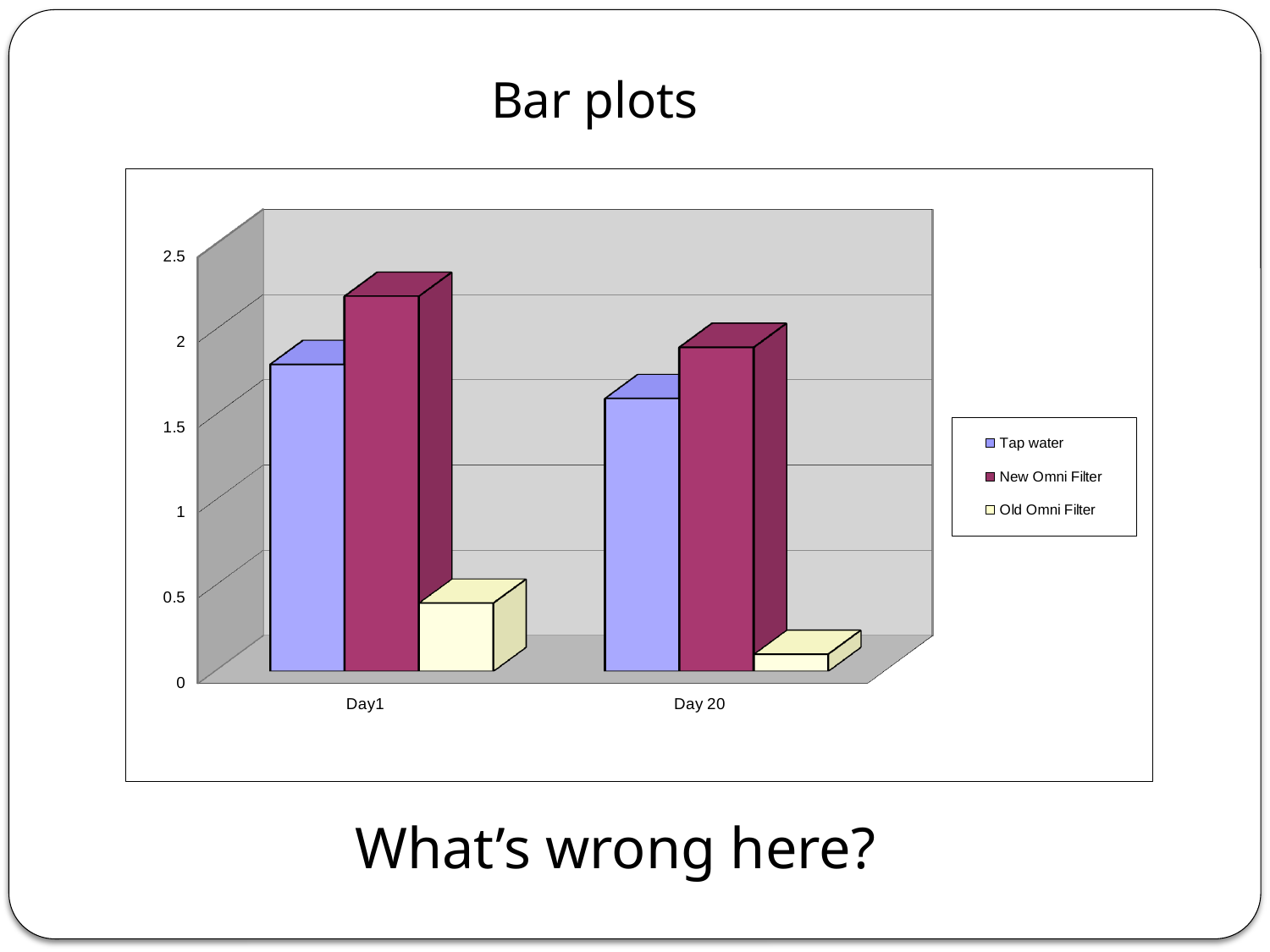
Which series has the highest value at Day1? New Omni Filter Is the value for Old Omni Filter at Day 20 greater or less than 0.5? less Does the Old Omni Filter value rise or fall from Day1 to Day 20? fall Is the value for Tap water at Day1 greater or less than 2? less Is the value for Tap water at Day 20 greater or less than 1.5? greater How many series does the legend list? 3 What kind of chart is shown on the slide? bar chart How many categories are shown on the x axis? 2 Which series has the lowest value at Day 20? Old Omni Filter Which is larger, the Tap water value at Day1 or at Day 20? Day1